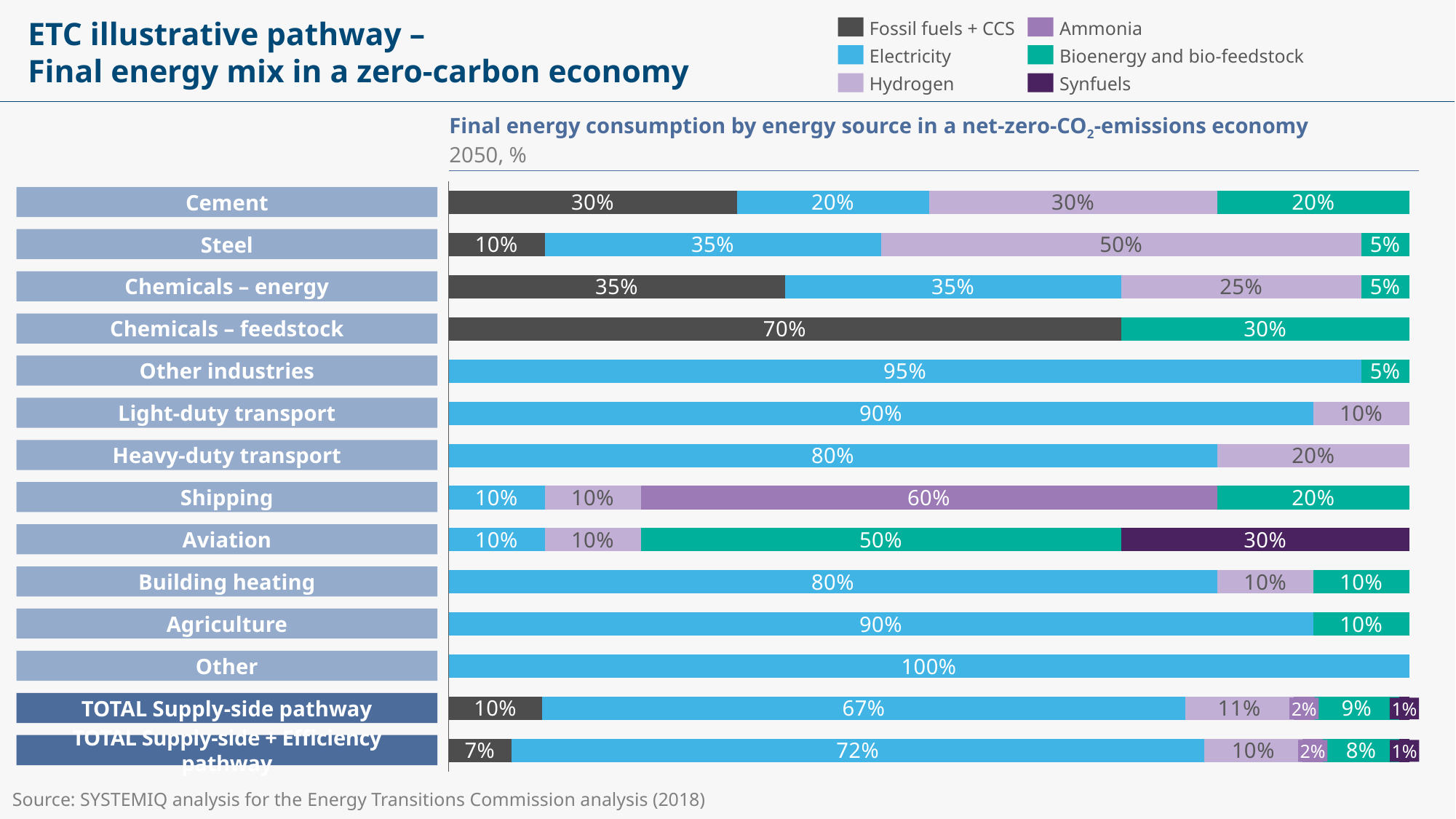
Which category has the highest Electricity share? Other How many categories (bars) are shown in the chart? 14 What is the Ammonia share for Shipping? 60% Which has a larger Bioenergy and bio-feedstock share, Aviation or Cement? Aviation What is the Hydrogen share for Steel? 50% What is the Synfuels share for Aviation? 30% What is the Electricity share in the TOTAL Supply-side + Efficiency pathway? 72% Which category has the highest Fossil fuels + CCS share? Chemicals – feedstock What is the subtitle (unit line) shown under the chart title? 2050, % What type of chart is shown on the slide? Stacked bar chart How many series does the legend list? 6 What is the difference between the Electricity share for Other industries and for Heavy-duty transport? 15%